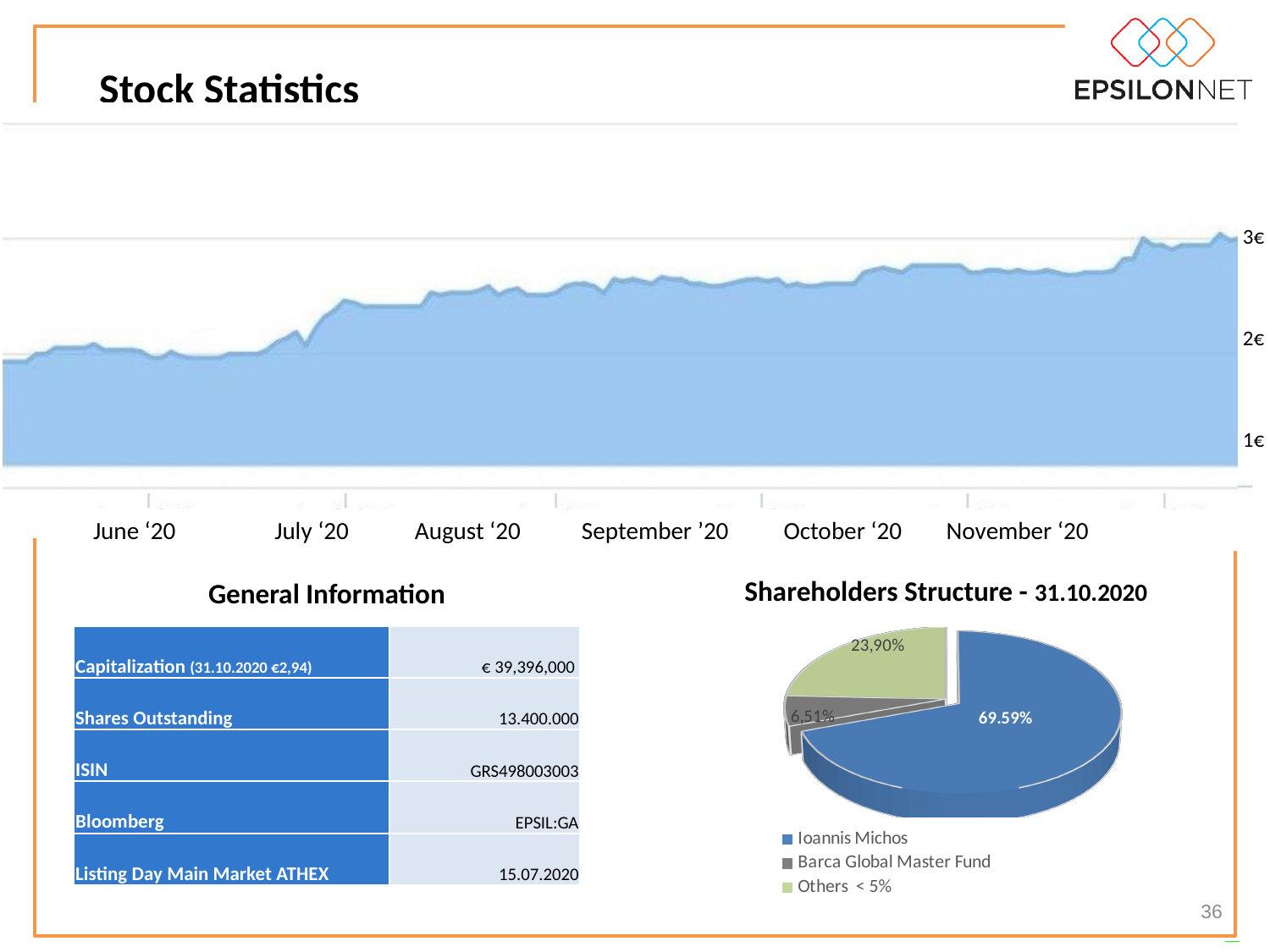
How many slices does the Shareholders Structure pie chart have? 3 On the Shareholders Structure pie chart, what share does Barca Global Master Fund hold? 6,51% On the stock price chart at the top of the slide, is the value in November '20 greater or less than 2€? greater On the stock price chart at the top of the slide, does the price generally rise or fall from June '20 to November '20? rise What kind of chart is the Shareholders Structure chart? Pie chart How many entries does the legend of the Shareholders Structure chart list? 3 On the Shareholders Structure pie chart, which shareholder has the smallest slice? Barca Global Master Fund On the Shareholders Structure pie chart, what share is held by Others < 5%? 23,90% On the Shareholders Structure pie chart, which shareholder has the largest slice? Ioannis Michos On the Shareholders Structure pie chart, what share does Ioannis Michos hold? 69.59% On the stock price chart at the top of the slide, is the value in June '20 greater or less than 2€? less On the Shareholders Structure pie chart, which is larger: the slice for Others < 5% or the slice for Barca Global Master Fund? Others < 5%